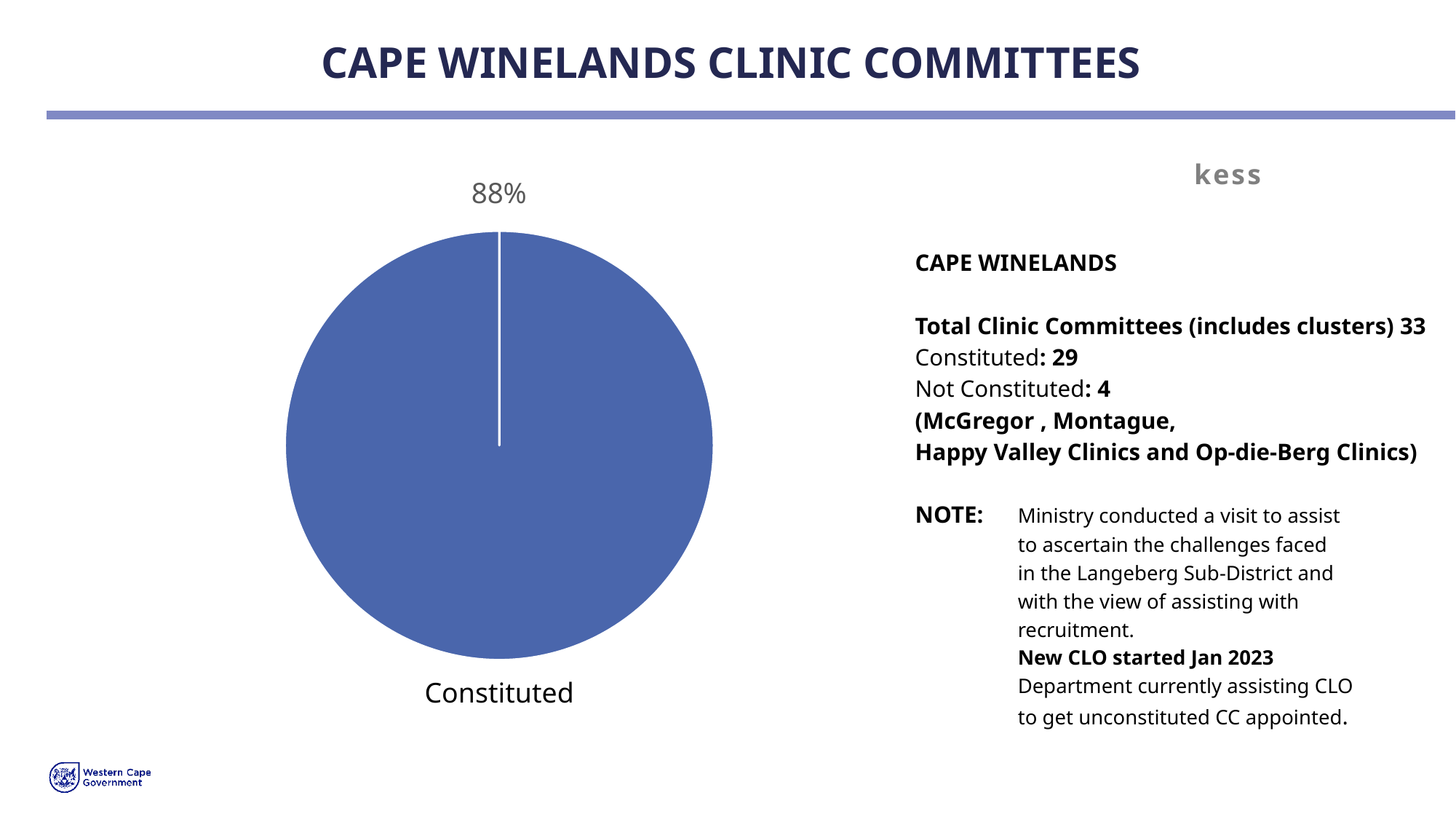
Which category label is shown beneath the pie chart? Constituted What is the title of the slide containing the pie chart? CAPE WINELANDS CLINIC COMMITTEES What kind of chart is shown on the slide? pie chart Is the share shown for the Constituted slice greater or less than 50%? greater What percentage is shown for the Constituted slice of the pie chart? 88%